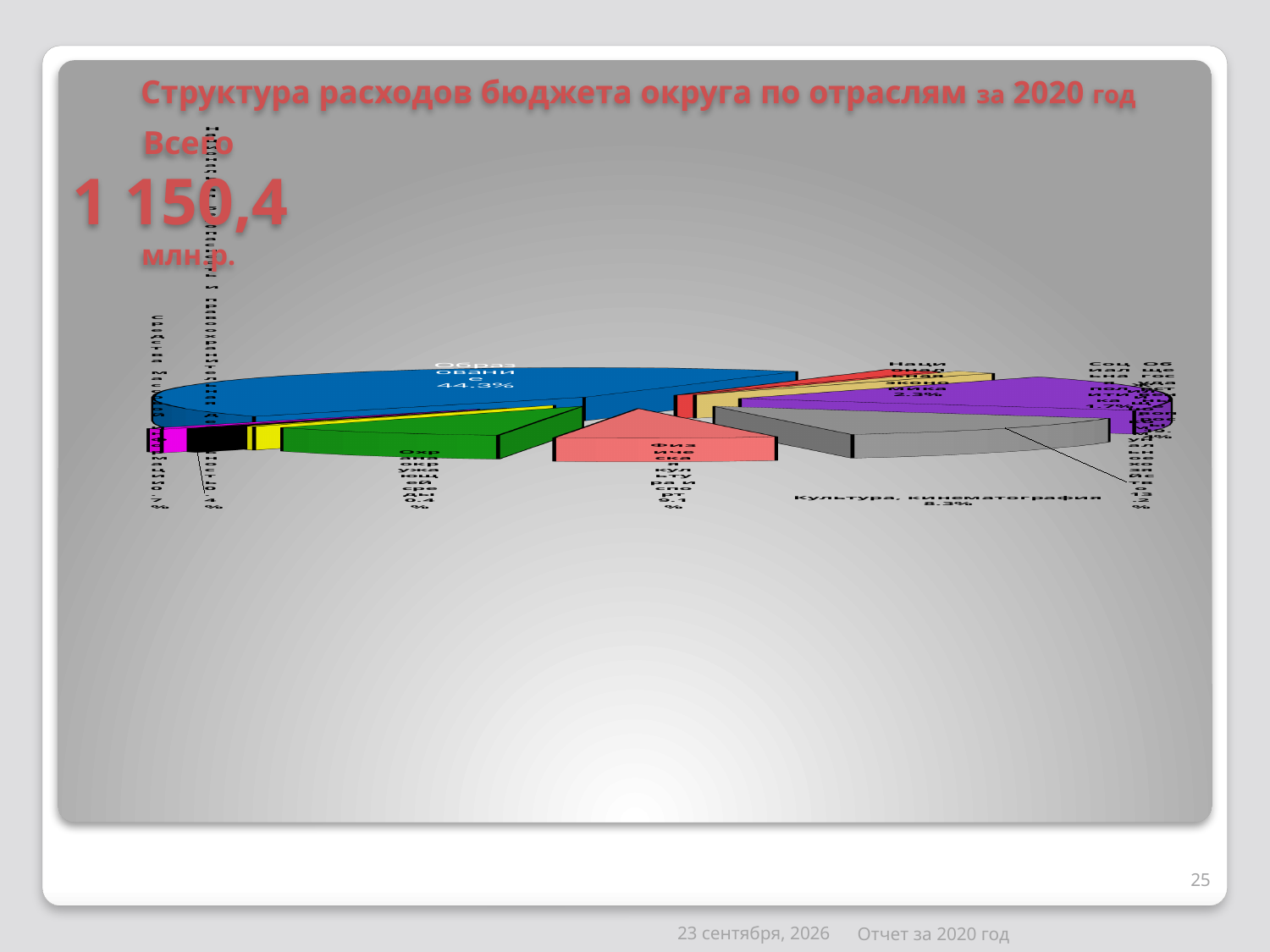
What kind of chart is shown on the slide? pie chart Which is larger: the share for Культура, кинематография or the share for Физическая культура и спорт? Физическая культура и спорт Which sector has the largest share of budget expenditure? Образование What share of the budget expenditure goes to Охрана окружающей среды? 0.4% What is the difference between the share for Образование and the share for Культура, кинематография? 36.0% What share of the budget expenditure goes to Культура, кинематография? 8.3% What total amount of expenditure (Всего) is stated on the slide? 1 150,4 млн.р. What share of the budget expenditure goes to Национальная экономика? 2.3% What share of the budget expenditure goes to Образование? 44.3% What is the title of the chart on the slide? Структура расходов бюджета округа по отраслям за 2020 год What is the difference between the share for Физическая культура и спорт and the share for Культура, кинематография? 0.8%